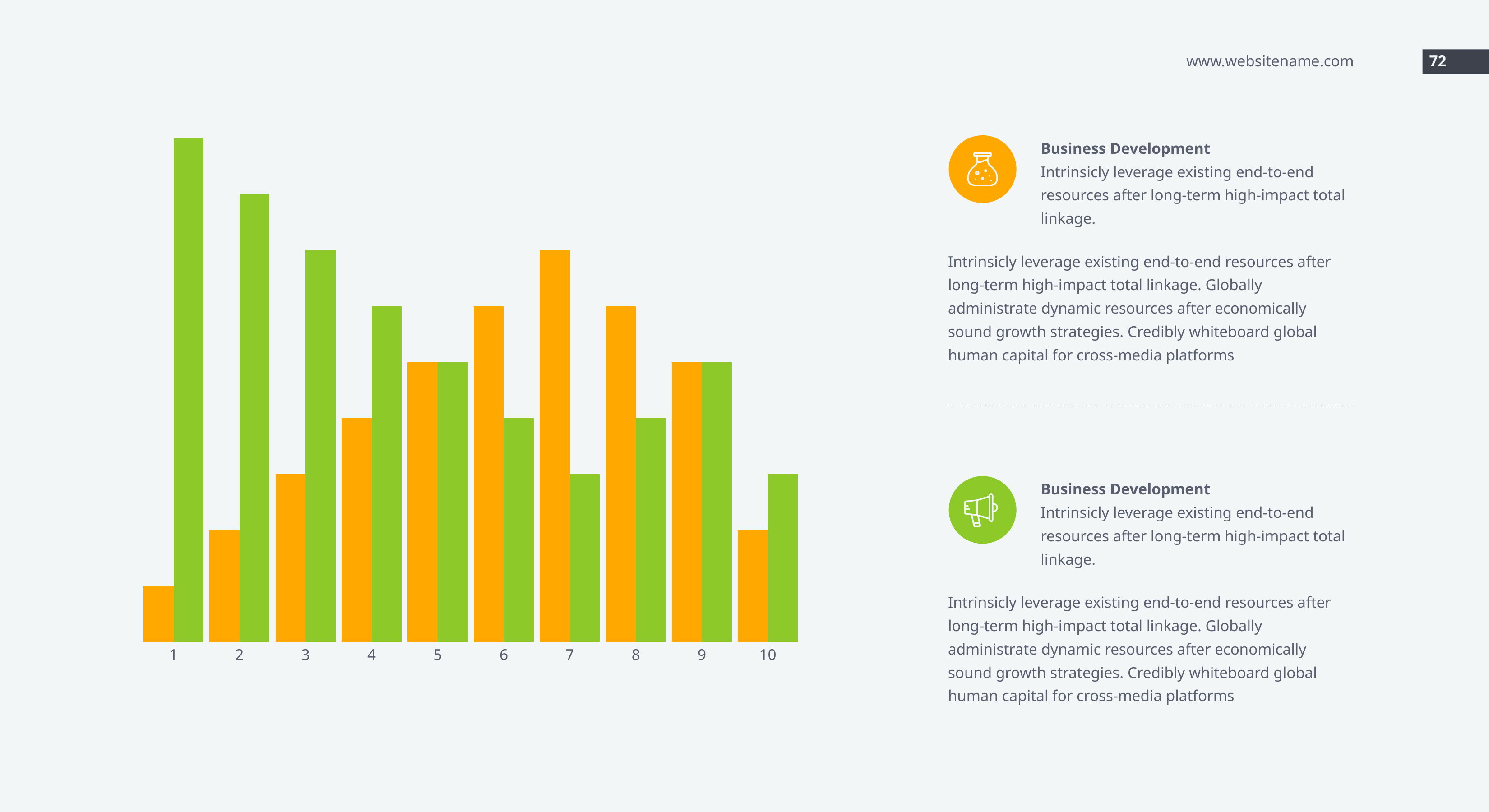
Which is taller, the green bar for category 2 or the green bar for category 3? category 2 Which category has the tallest orange bar? 7 In category 7, which bar is taller, the orange one or the green one? orange Which category has the shortest orange bar? 1 What two colours are used for the bars in the chart? orange and green How many categories are shown on the x axis of the chart? 10 In category 1, which bar is taller, the orange one or the green one? green How many data series are plotted in the chart? 2 What kind of chart is shown on the slide? bar chart Do the orange bars rise or fall from category 1 to category 7? rise Do the green bars rise or fall from category 1 to category 4? fall Which category has the tallest green bar? 1